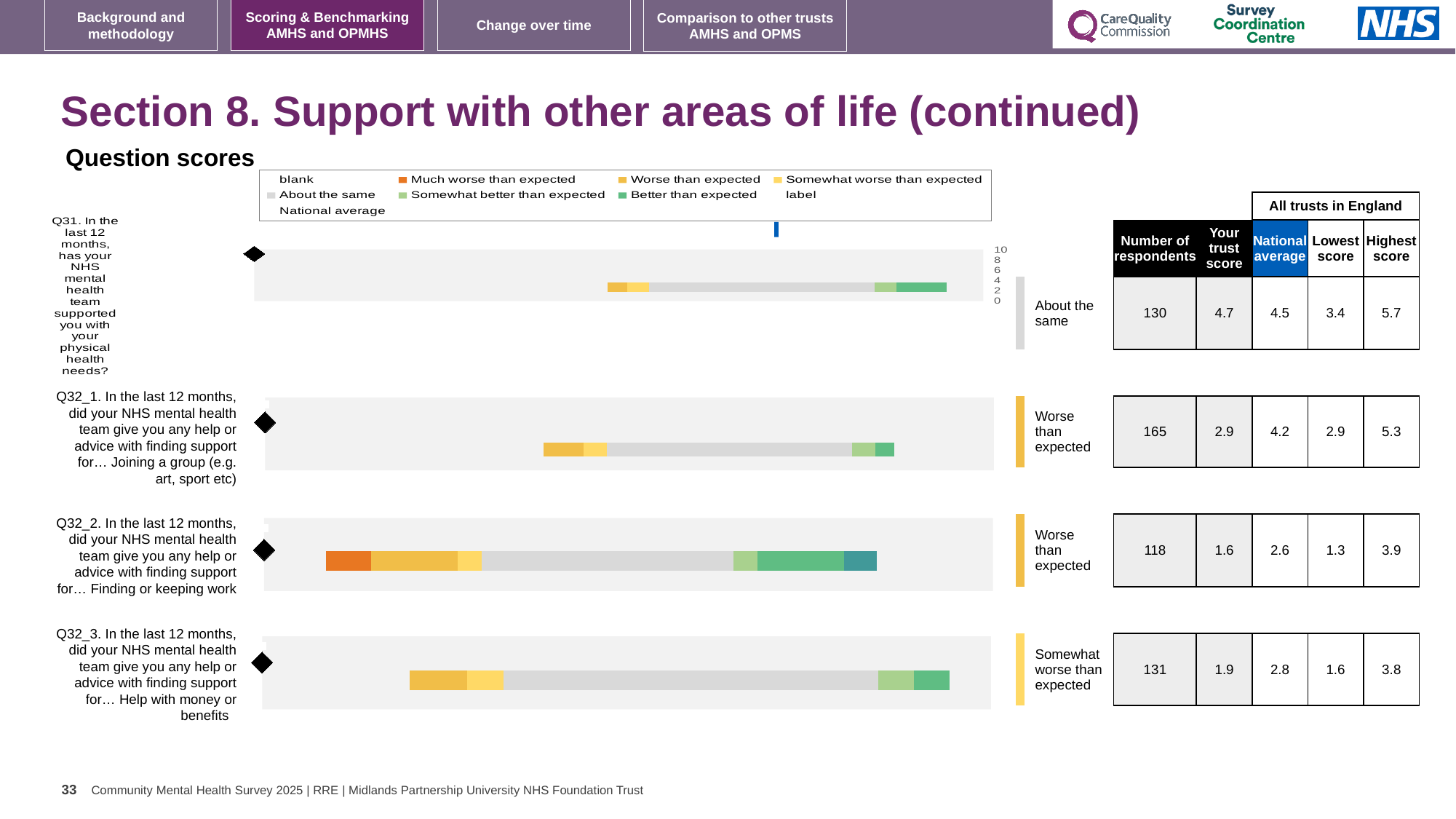
For the Q31 chart, what is the difference between the highest score and the lowest score across all trusts in England? 2.3 How many question score charts are shown on the slide? 4 For the Q31 chart, is the trust's score higher or lower than the national average? higher Which question chart is labelled 'Somewhat worse than expected'? Q32_3 (Help with money or benefits) For the Q31 chart (support with physical health needs), what is the national average? 4.5 For the Q32_1 chart (joining a group), how many respondents are there? 165 For the Q32_2 chart (finding or keeping work), how much lower is the trust's score than the national average? 1.0 What kind of chart is used to show the question scores on this slide? bar chart For the Q32_3 chart (help with money or benefits), what is the highest score among all trusts in England? 3.8 Which question chart has the lowest trust score? Q32_2 (Finding or keeping work) For the Q31 chart (support with physical health needs), what is the trust's score? 4.7 For the Q32_2 chart (finding or keeping work), what is the lowest score among all trusts in England? 1.3